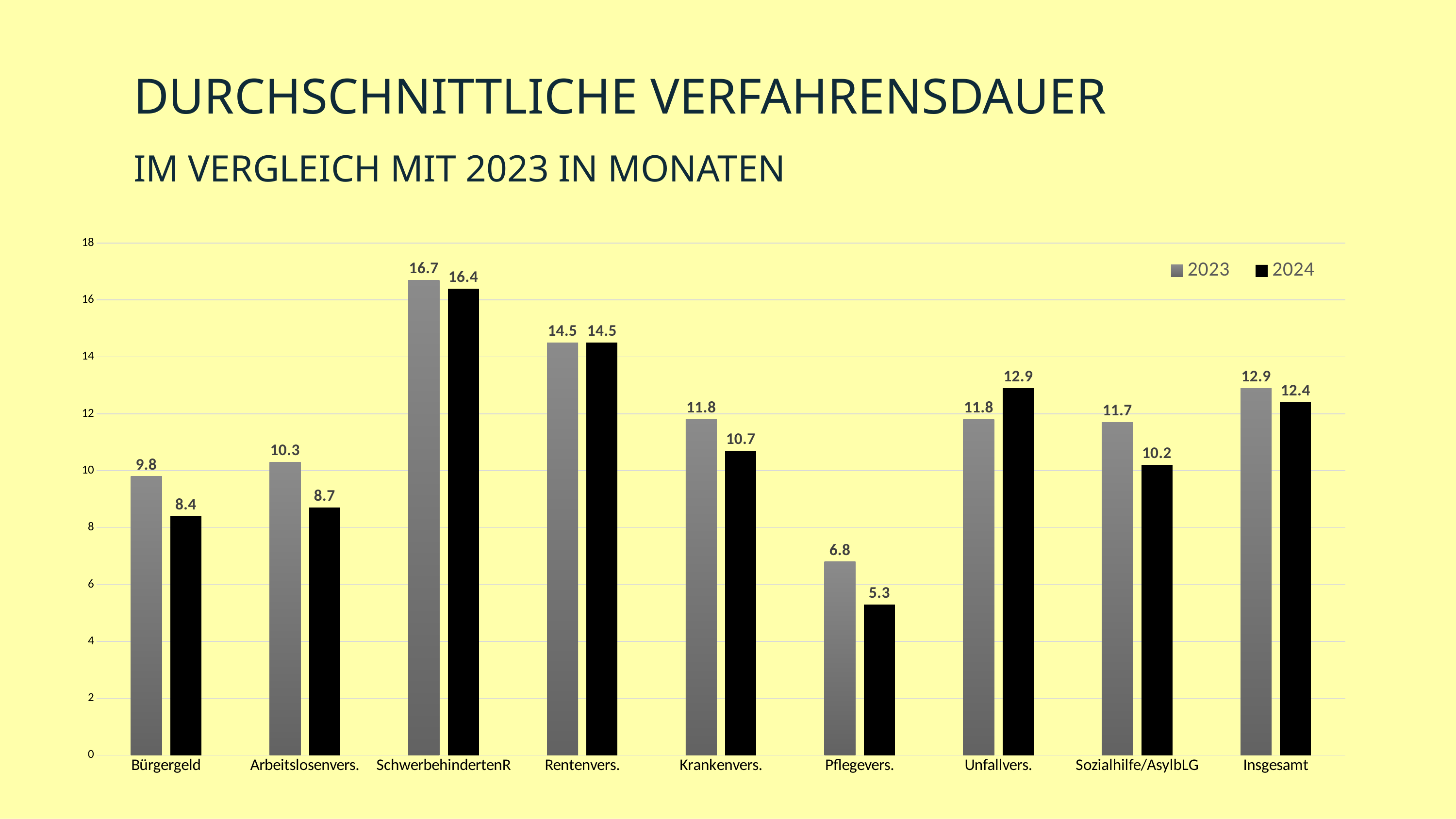
What is the difference between the 2023 and 2024 values for Krankenvers.? 1.1 What kind of chart is shown on the slide? bar chart Which category has the highest 2023 value? SchwerbehindertenR Which category has the lowest 2024 value? Pflegevers. Which is larger for Unfallvers., the 2023 value or the 2024 value? 2024 What is the 2024 value for Bürgergeld? 8.4 How many categories are shown on the x axis? 9 What is the 2024 value for Sozialhilfe/AsylbLG? 10.2 How many series does the legend list? 2 What colour are the bars for the 2024 series? black Is the 2024 value for Insgesamt greater or less than 12? greater What is the 2023 value for Pflegevers.? 6.8